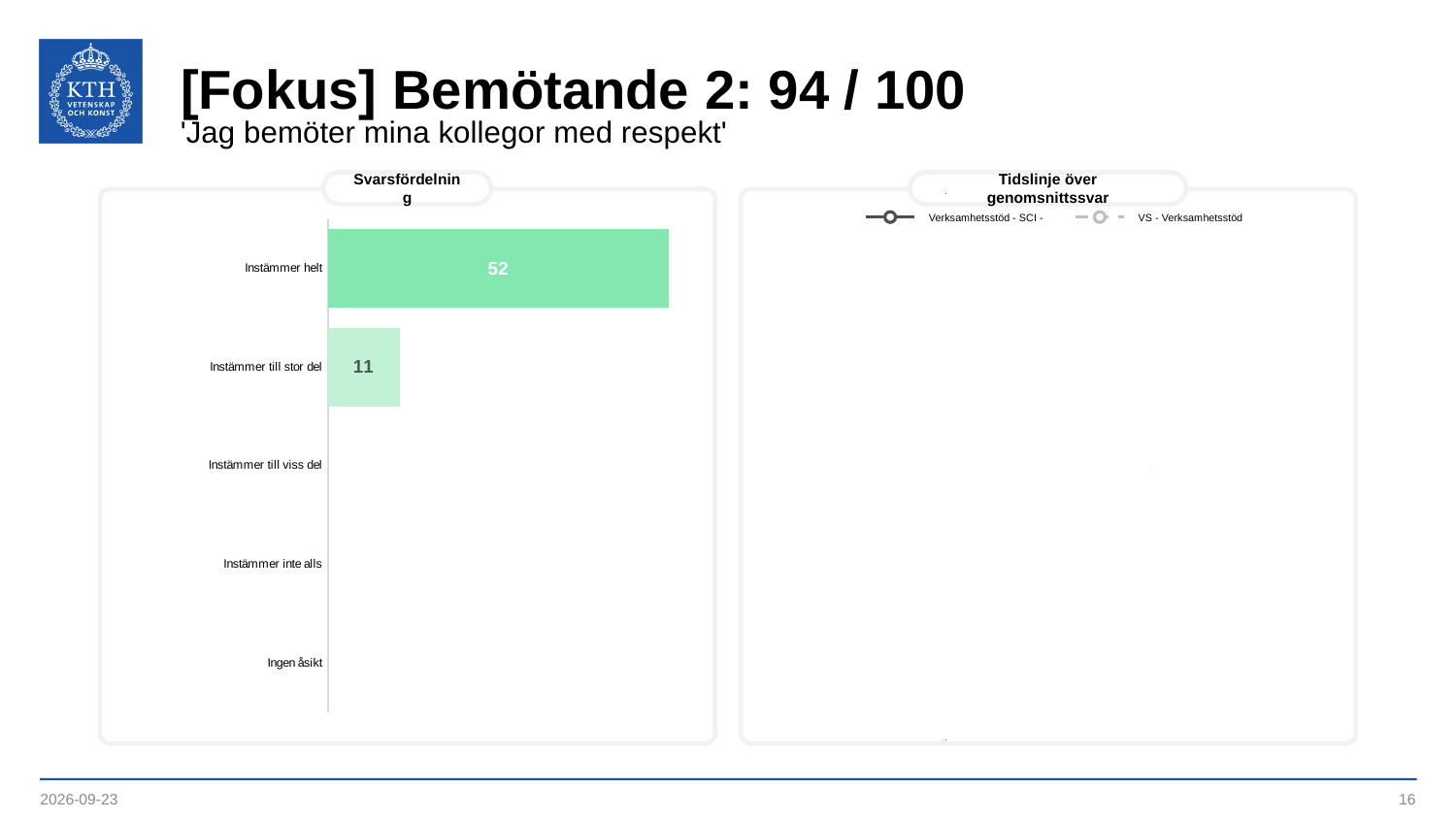
What is the title of the chart on the left side of the slide? Svarsfördelning What kind of chart is the Svarsfördelning chart? Bar chart In the Svarsfördelning chart, which is larger: the value for 'Instämmer helt' or for 'Instämmer till stor del'? Instämmer helt In the Svarsfördelning chart, what is the value for 'Instämmer helt'? 52 In the Svarsfördelning chart, what is the value for 'Instämmer till stor del'? 11 In the Svarsfördelning chart, which category has the highest value? Instämmer helt In the Svarsfördelning chart, what is the difference between the values for 'Instämmer helt' and 'Instämmer till stor del'? 41 How many series does the legend of the 'Tidslinje över genomsnittssvar' chart list? 2 What is the title of the chart on the right side of the slide? Tidslinje över genomsnittssvar How many categories are listed on the axis of the Svarsfördelning chart? 5